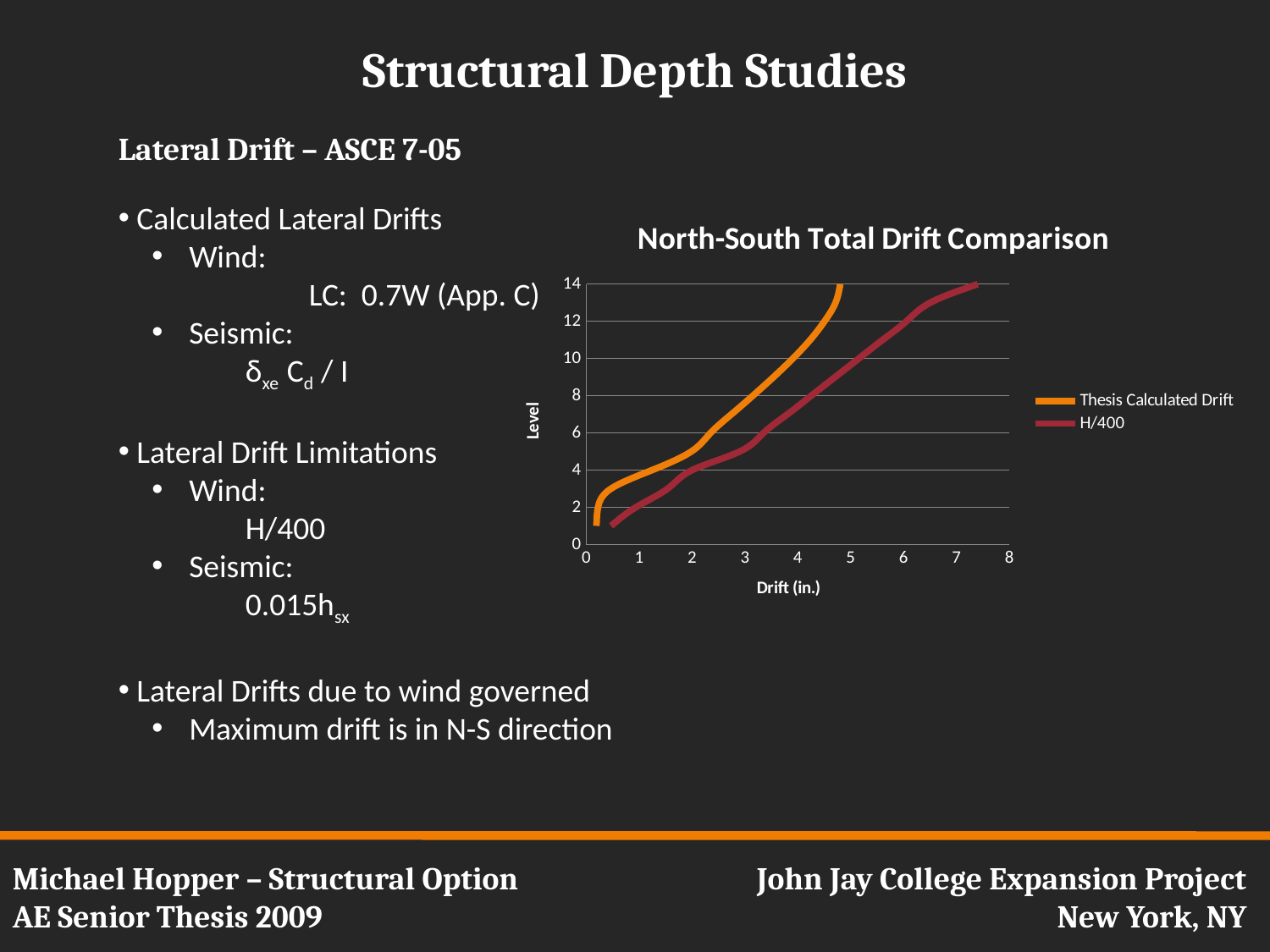
Is the drift for the Thesis Calculated Drift series at Level 14 greater or less than 6? less Which series has the smaller drift at Level 10, Thesis Calculated Drift or H/400? Thesis Calculated Drift How many series does the legend of the chart list? 2 Which series reaches a larger drift at Level 14, Thesis Calculated Drift or H/400? H/400 Does the Level rise or fall as Drift increases along the x axis for the Thesis Calculated Drift series? rise Is the drift for the H/400 series at Level 14 greater or less than 6? greater What is the title of the chart? North-South Total Drift Comparison Is the drift for the Thesis Calculated Drift series at Level 6 greater or less than 3? less What is the label of the horizontal axis of the chart? Drift (in.) What kind of chart is shown on the slide? line chart